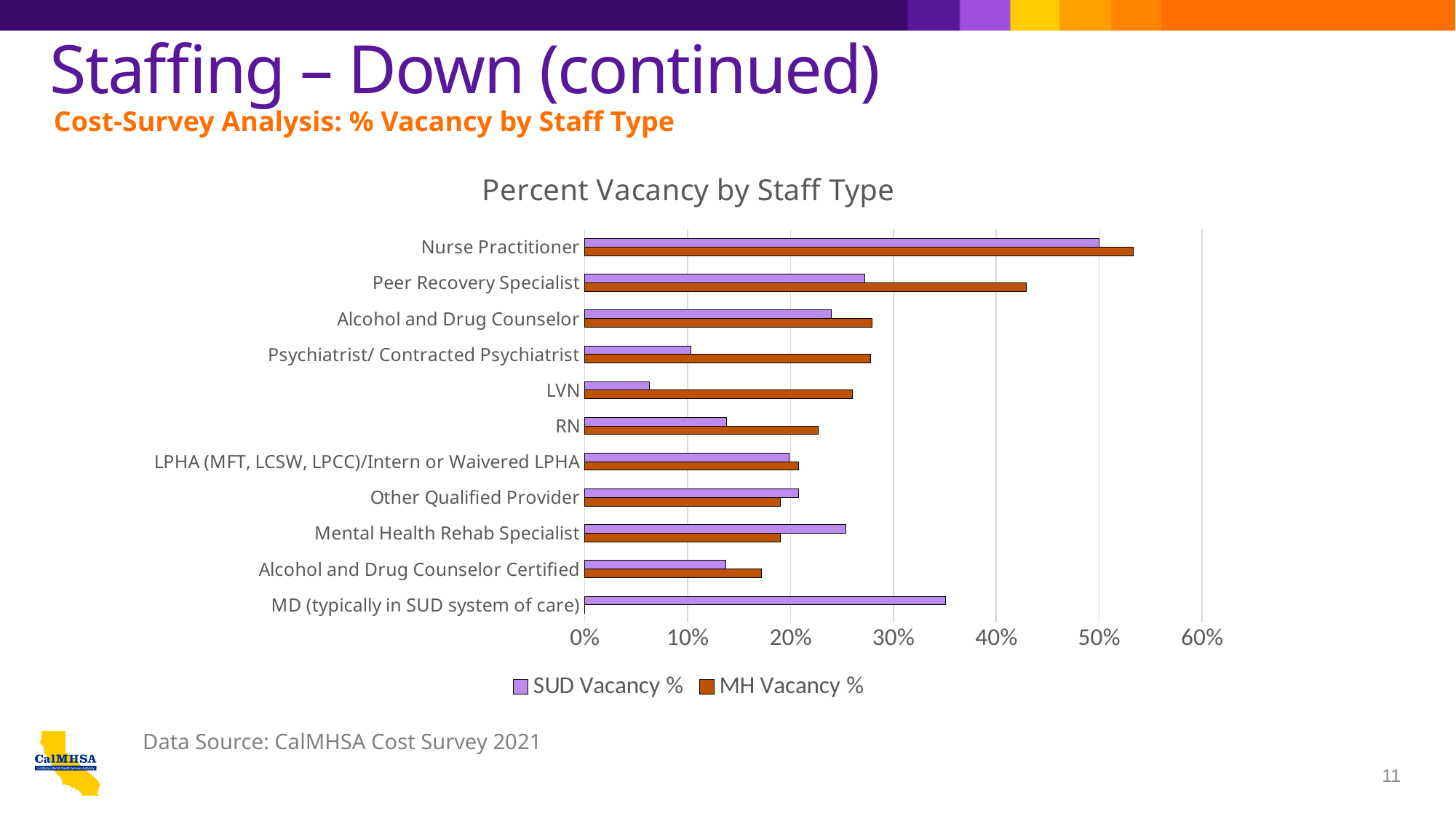
For Peer Recovery Specialist, which is larger: SUD Vacancy % or MH Vacancy %? MH Vacancy % Is the MH Vacancy % for Nurse Practitioner greater or less than 50%? greater Which staff type has the highest SUD Vacancy %? Nurse Practitioner Is the SUD Vacancy % for LVN greater or less than 10%? less Which staff type has the highest MH Vacancy %? Nurse Practitioner Is the SUD Vacancy % for MD (typically in SUD system of care) greater or less than 30%? greater For Mental Health Rehab Specialist, which is larger: SUD Vacancy % or MH Vacancy %? SUD Vacancy % What kind of chart is shown on the slide? Bar chart How many staff types are shown on the chart? 11 How many series does the legend list? 2 Which staff type has the lowest SUD Vacancy %? LVN